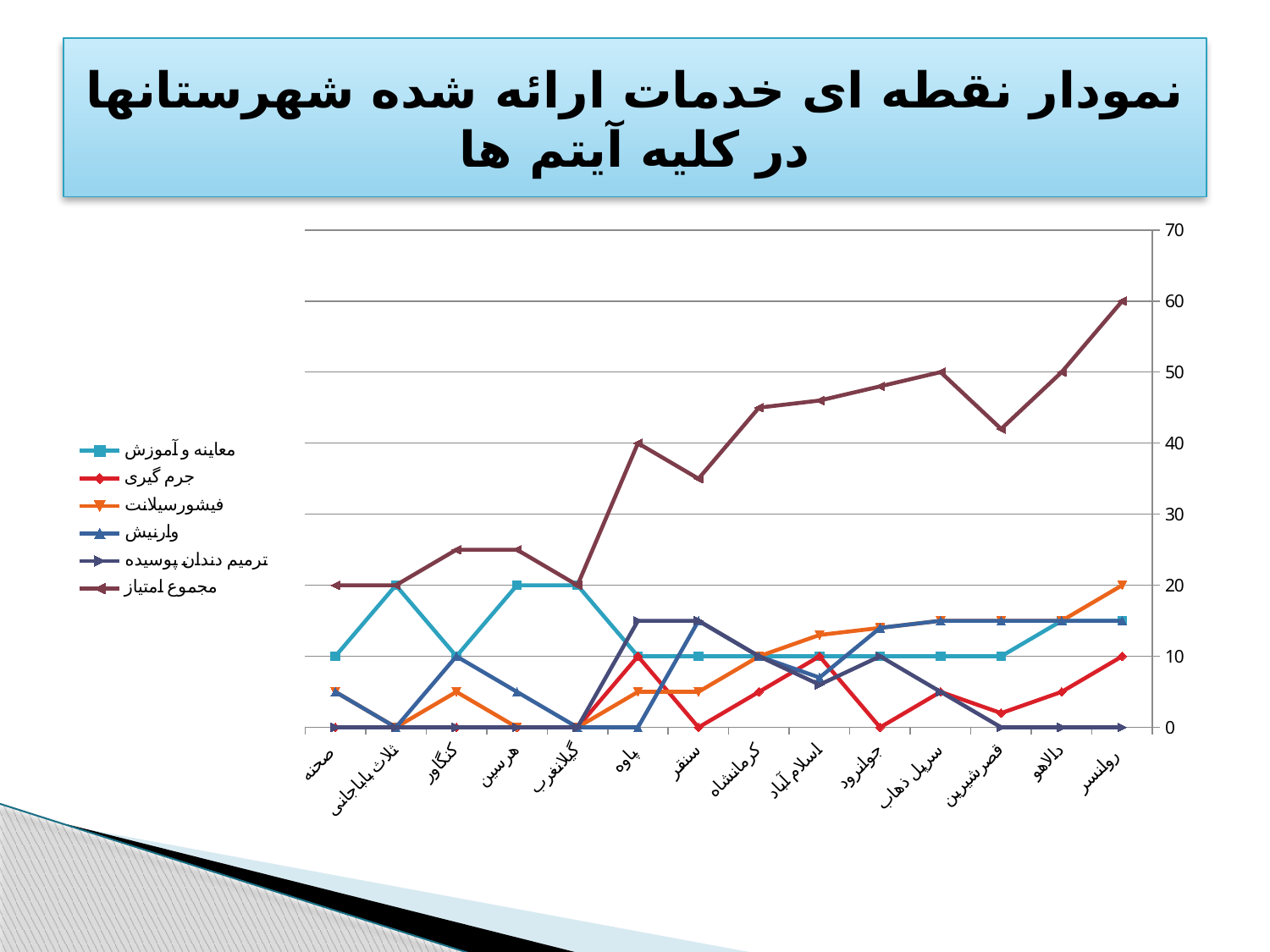
What is the value of مجموع امتیاز for روانسر? 60 Is the value of مجموع امتیاز for کرمانشاه greater or less than 40? greater What is the value of مجموع امتیاز for پاوه? 40 How many series does the legend list? 6 What kind of chart is shown on the slide? line chart Is the value of مجموع امتیاز for سنقر greater or less than 40? less Does the مجموع امتیاز series generally rise or fall from left to right along the x axis? rise How many categories (cities) are shown along the x axis? 14 Which has the larger مجموع امتیاز value, پاوه or سنقر? پاوه Which category has the highest value for مجموع امتیاز? روانسر What is the value of معاینه و آموزش for هرسین? 20 What is the difference between the مجموع امتیاز values for روانسر and دالاهو? 10